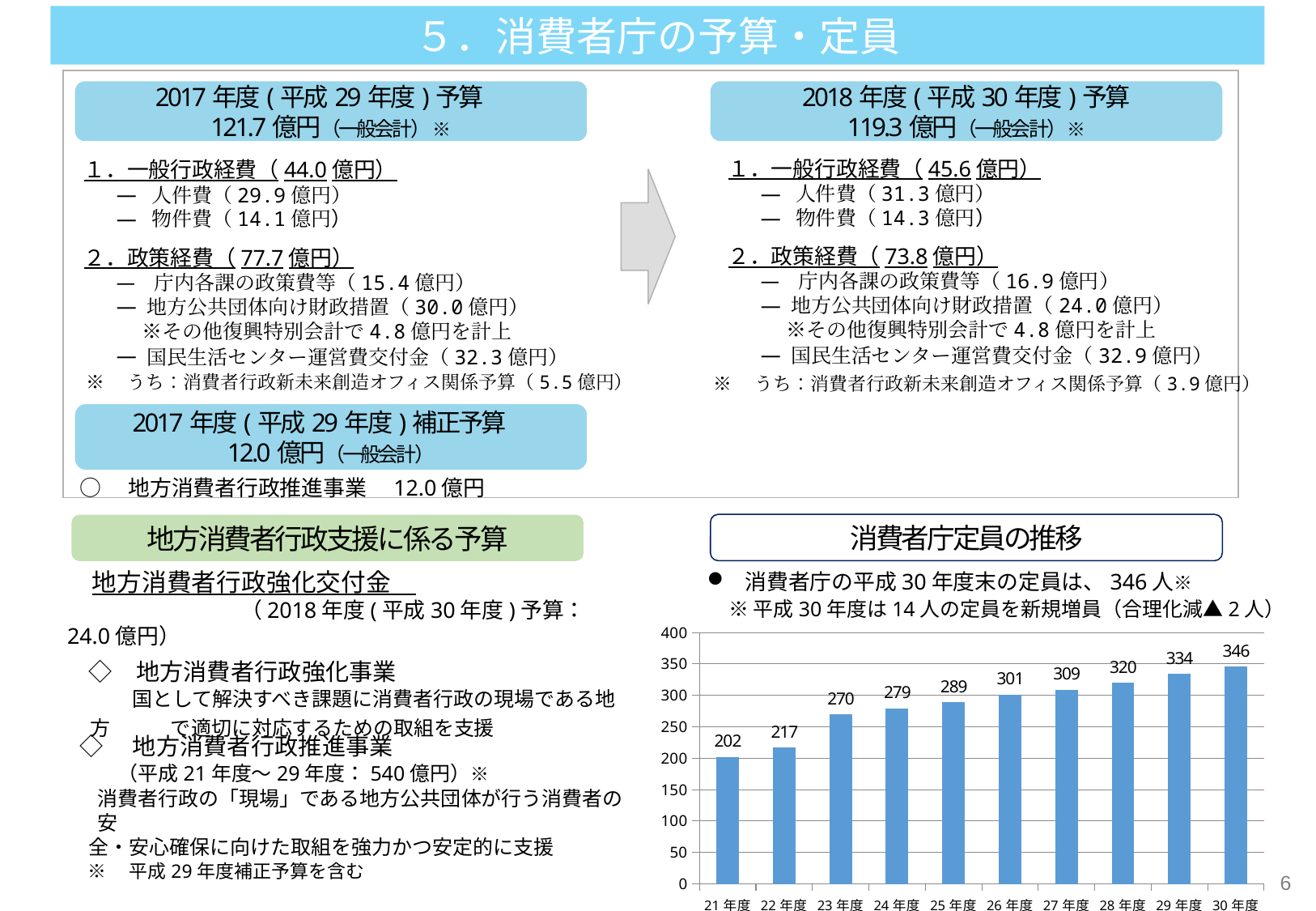
What is the difference between the values for 30年度 and 21年度 in the 消費者庁定員の推移 chart? 144 Which year has the lowest value in the 消費者庁定員の推移 chart? 21年度 Do the values in the 消費者庁定員の推移 chart rise or fall from 21年度 to 30年度? rise Is the value for 24年度 in the 消費者庁定員の推移 chart greater or less than 250? greater What is the value for 21年度 in the 消費者庁定員の推移 chart? 202 In the 消費者庁定員の推移 chart, which is larger, the value for 25年度 or the value for 26年度? 26年度 What kind of chart is the 消費者庁定員の推移 chart? bar chart How many years are shown on the x axis of the 消費者庁定員の推移 chart? 10 What is the value for 27年度 in the 消費者庁定員の推移 chart? 309 Which year has the highest value in the 消費者庁定員の推移 chart? 30年度 What is the value for 23年度 in the 消費者庁定員の推移 chart? 270 What is the difference between the values for 23年度 and 22年度 in the 消費者庁定員の推移 chart? 53